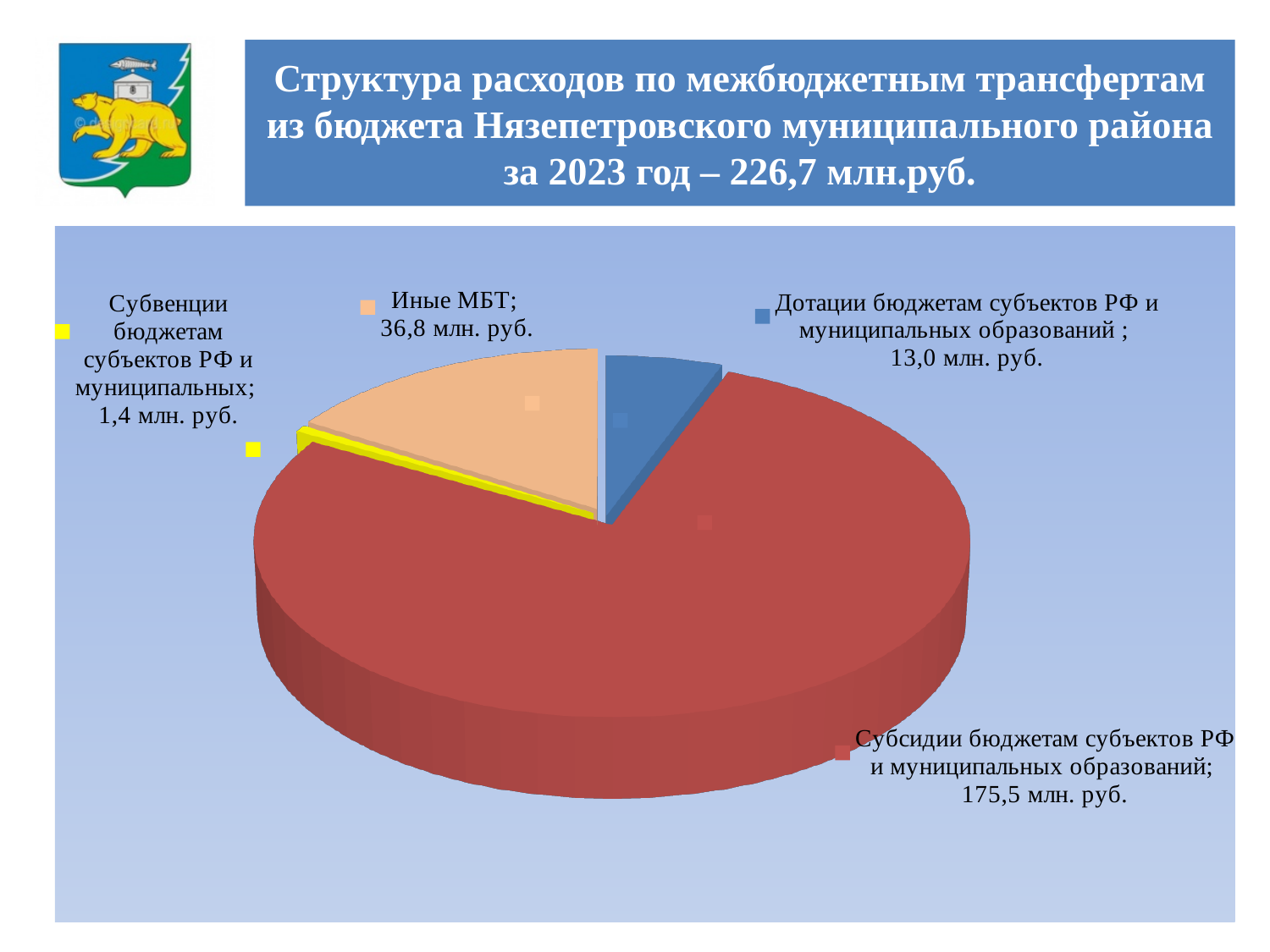
What colour is the slice for Субвенции бюджетам субъектов РФ и муниципальных? Yellow What is the value for Дотации бюджетам субъектов РФ и муниципальных образований? 13,0 млн. руб. What is the value for Субсидии бюджетам субъектов РФ и муниципальных образований? 175,5 млн. руб. What is the difference between Субсидии (175,5 млн. руб.) and Иные МБТ (36,8 млн. руб.)? 138,7 млн. руб. What share of the total 226,7 млн. руб. do Субсидии (175,5 млн. руб.) represent? 77,4% What kind of chart is shown on the slide? Pie chart What is the value for Иные МБТ? 36,8 млн. руб. Which category has the largest slice of the pie? Субсидии бюджетам субъектов РФ и муниципальных образований Which category has the smallest slice of the pie? Субвенции бюджетам субъектов РФ и муниципальных What is the value for Субвенции бюджетам субъектов РФ и муниципальных? 1,4 млн. руб. How many slices does the pie chart have? 4 Which is larger: Иные МБТ or Дотации бюджетам субъектов РФ и муниципальных образований? Иные МБТ